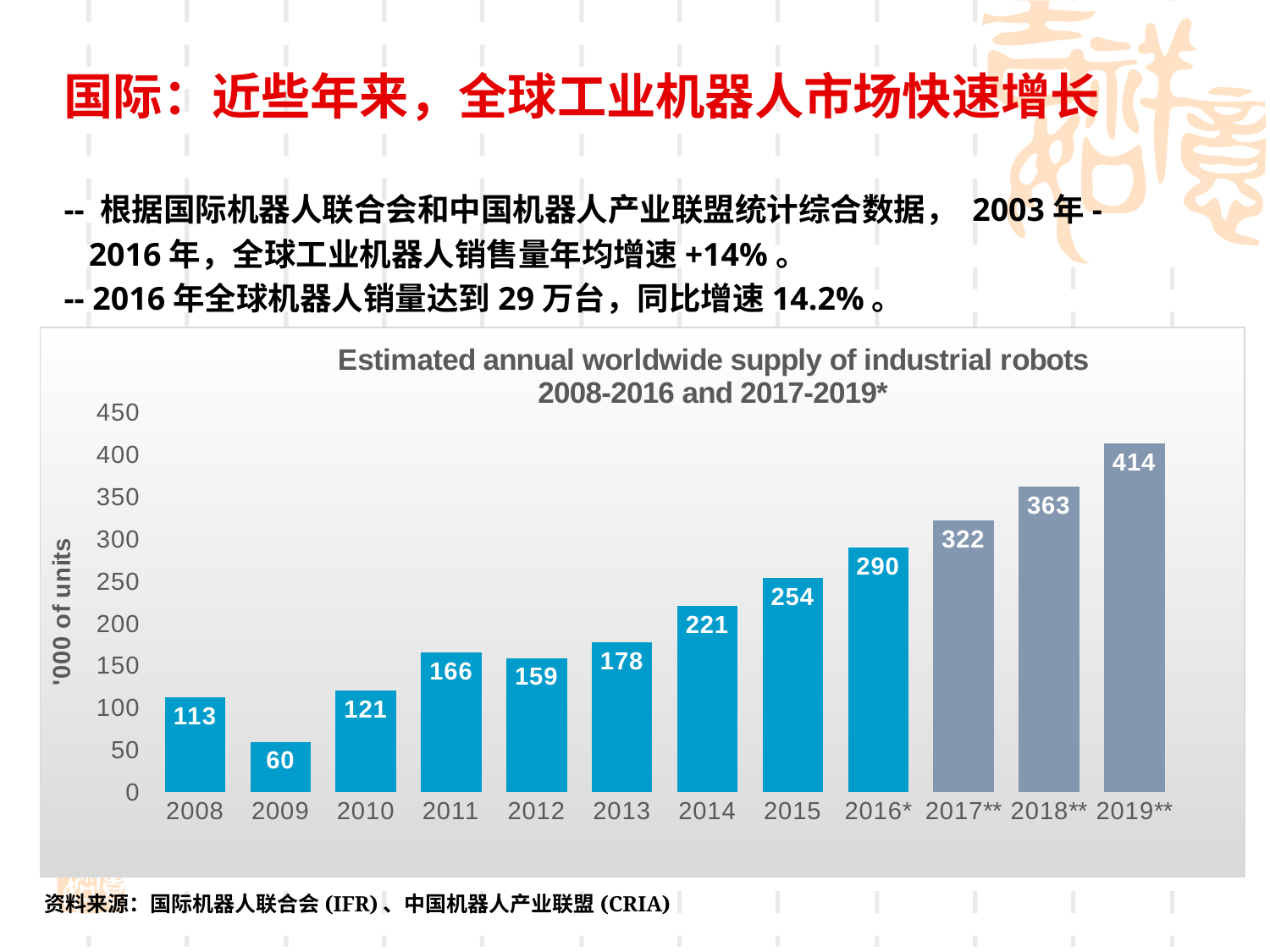
Is the value for 2017** greater or less than 300? greater What is the value for 2019**? 414 How many years are shown on the x axis? 12 What is the difference between the values for 2016* and 2015? 36 Which is larger, the value for 2011 or the value for 2012? 2011 Which year has the lowest value? 2009 What kind of chart is this? bar chart What is the value for 2008? 113 What is the value for 2014? 221 Which year has the highest value? 2019** Do the values generally rise or fall from 2009 to 2019**? rise What is the label on the y axis? '000 of units